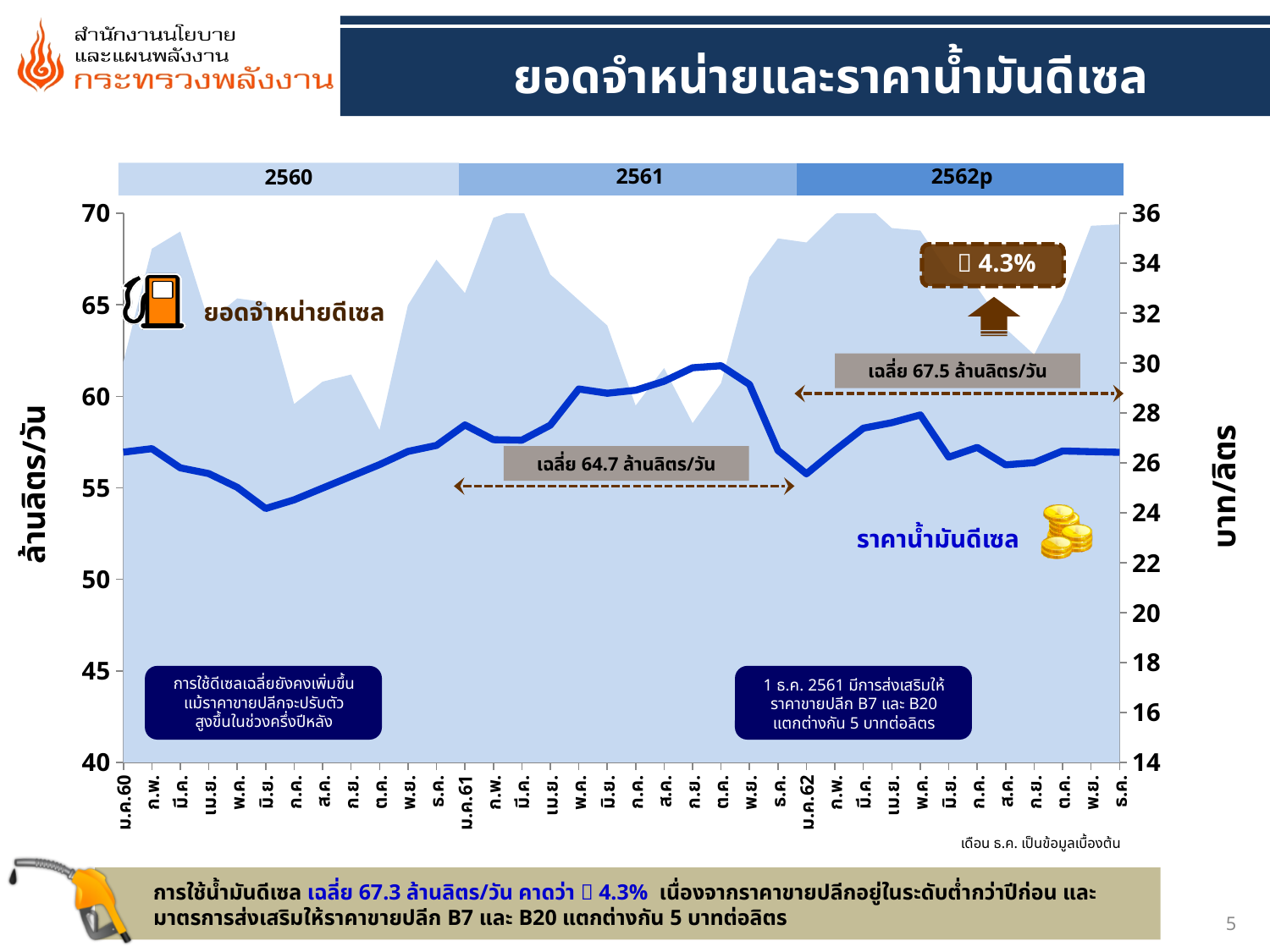
What percentage change is shown in the callout above the 2562p period? 4.3% Is the diesel price (ราคาน้ำมันดีเซล) in ม.ค.60 greater or less than 28 บาท/ลิตร? less What kind of chart is shown on the slide? area and line chart What is the difference between the average diesel sales for 2562p (67.5) and 2561 (64.7)? 2.8 ล้านลิตร/วัน How many year periods are labelled across the top of the chart? 3 Is the diesel price (ราคาน้ำมันดีเซล) in ต.ค.61 greater or less than 28 บาท/ลิตร? greater What is the average diesel sales volume shown for 2562p? 67.5 ล้านลิตร/วัน Does the diesel price line rise or fall from ม.ค.61 to ต.ค.61? rise What is the average diesel sales volume shown for 2561? 64.7 ล้านลิตร/วัน Which period has the higher average diesel sales, 2561 or 2562p? 2562p What is the label of the right-hand vertical axis? บาท/ลิตร